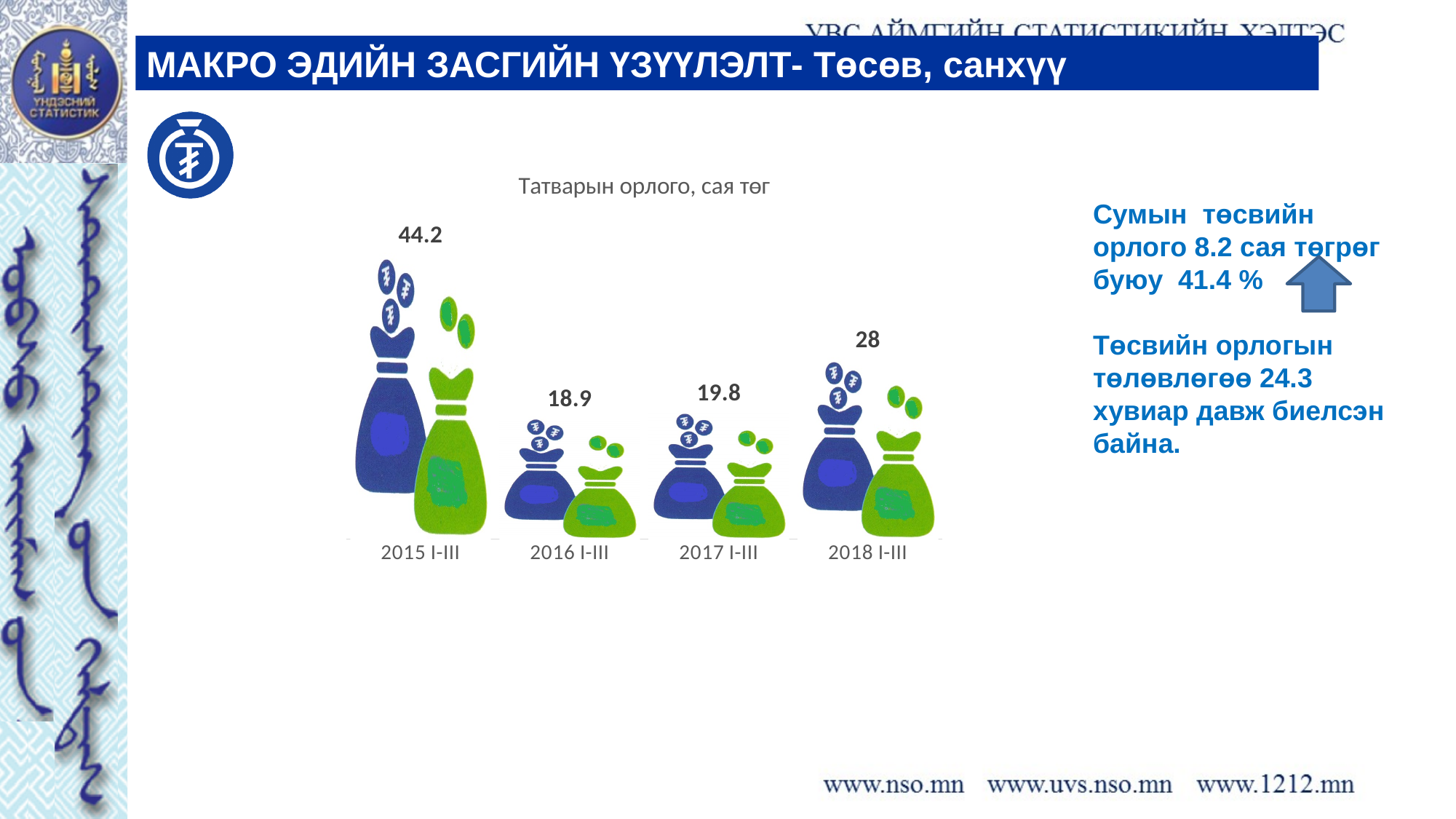
Which period has the highest tax revenue value? 2015 I-III What is the title of the chart? Татварын орлого, сая төг How many periods are shown on the x axis of the chart? 4 What is the tax revenue value shown for 2017 I-III? 19.8 What is the tax revenue value shown for 2018 I-III? 28 What is the tax revenue value shown for 2015 I-III? 44.2 Which period has the lowest tax revenue value? 2016 I-III Do the tax revenue values rise or fall from 2016 I-III to 2018 I-III? rise What is the difference between the tax revenue values for 2015 I-III and 2018 I-III? 16.2 What is the difference between the tax revenue values for 2018 I-III and 2017 I-III? 8.2 Which is larger, the tax revenue value for 2017 I-III or for 2016 I-III? 2017 I-III What is the tax revenue value shown for 2016 I-III? 18.9